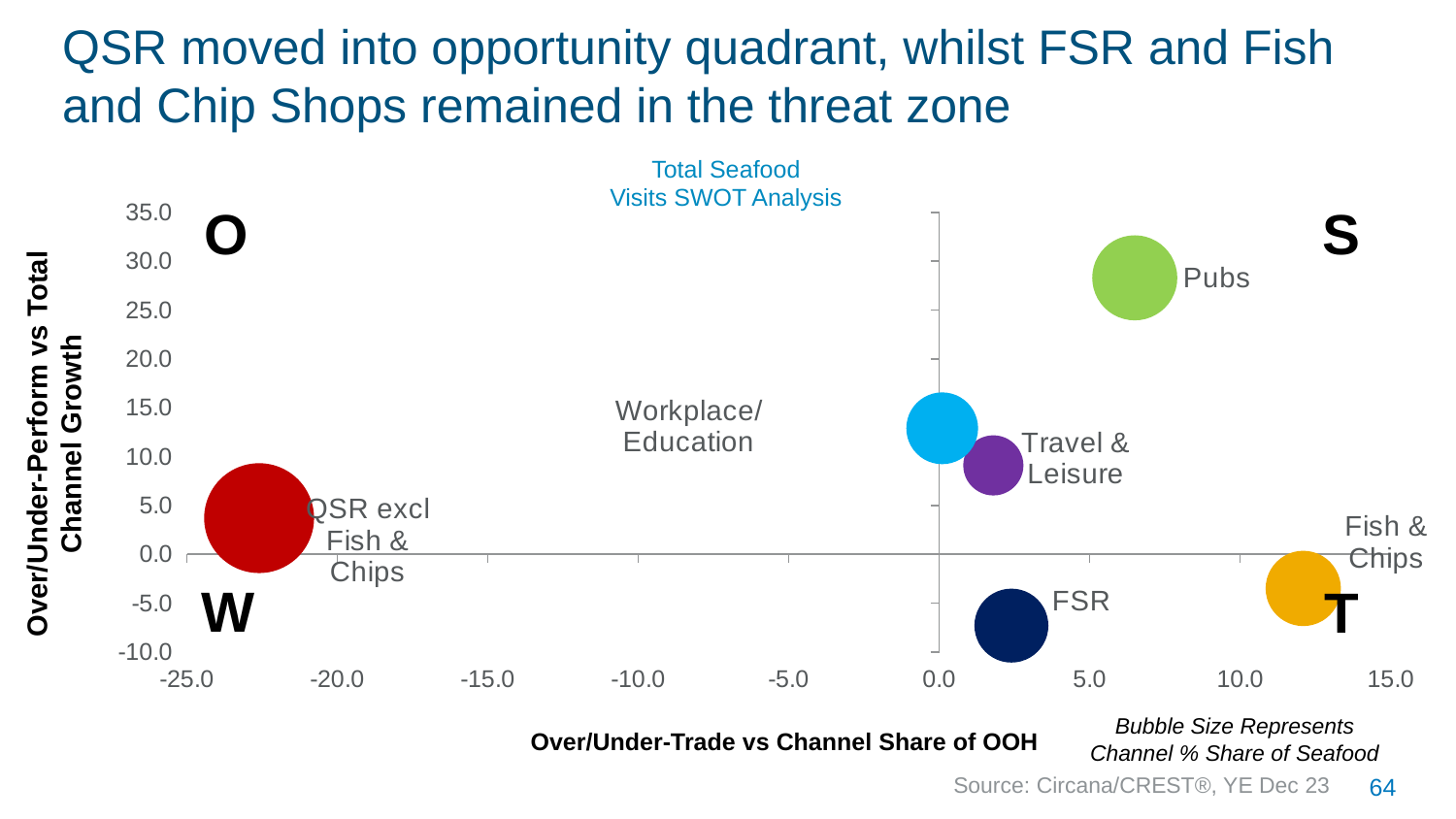
Which channel has the lowest Over/Under-Trade vs Channel Share of OOH value (furthest left)? QSR excl Fish & Chips What is the title of the chart? Total Seafood Visits SWOT Analysis Is the Over/Under-Perform vs Total Channel Growth value for Pubs greater or less than 25.0? greater Is the Over/Under-Trade vs Channel Share of OOH value for QSR excl Fish & Chips greater or less than -20.0? less Which has the larger Over/Under-Perform vs Total Channel Growth value, Workplace/Education or Travel & Leisure? Workplace/Education Is the Over/Under-Trade vs Channel Share of OOH value for Fish & Chips greater or less than 10.0? greater How many channel bubbles are plotted on the chart? 6 Which channel has the highest Over/Under-Perform vs Total Channel Growth value? Pubs What kind of chart is shown on the slide? Bubble chart Which channel has the lowest Over/Under-Perform vs Total Channel Growth value? FSR Which channel has the highest Over/Under-Trade vs Channel Share of OOH value (furthest right)? Fish & Chips